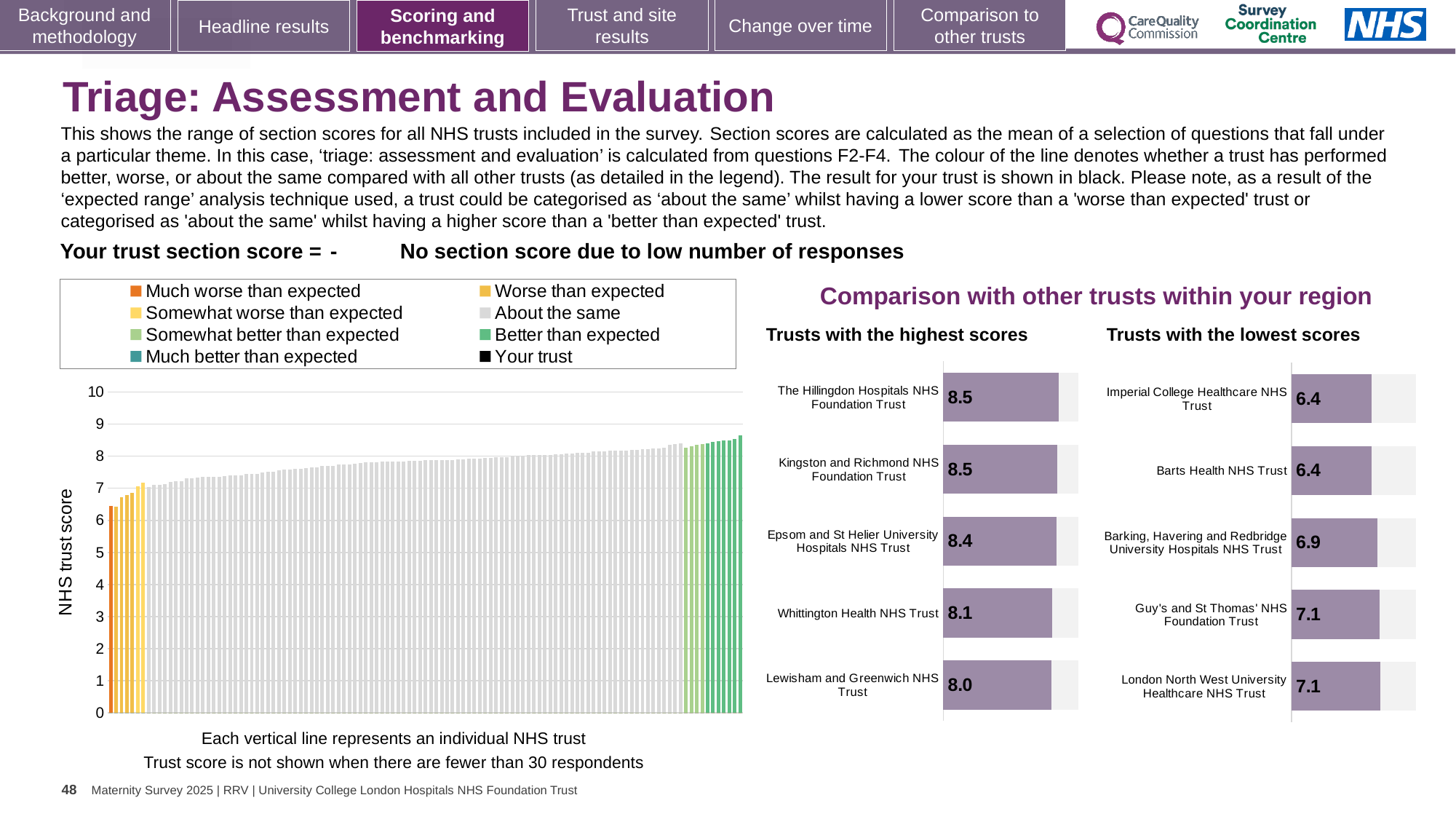
In the 'Trusts with the lowest scores' chart, what is the score for Barking, Havering and Redbridge University Hospitals NHS Trust? 6.9 In the 'Trusts with the highest scores' chart, what is the difference between the scores of The Hillingdon Hospitals NHS Foundation Trust and Lewisham and Greenwich NHS Trust? 0.5 How many entries does the legend of the main 'NHS trust score' chart list? 8 In the 'Trusts with the highest scores' chart, which trust has the lowest score? Lewisham and Greenwich NHS Trust In the 'Trusts with the lowest scores' chart, what is the score for Imperial College Healthcare NHS Trust? 6.4 How many trusts are shown in the 'Trusts with the lowest scores' chart? 5 Which has a higher score: Whittington Health NHS Trust in the 'Trusts with the highest scores' chart or Guy's and St Thomas' NHS Foundation Trust in the 'Trusts with the lowest scores' chart? Whittington Health NHS Trust In the 'Trusts with the highest scores' chart, what is the score for Epsom and St Helier University Hospitals NHS Trust? 8.4 In the main 'NHS trust score' chart, do the values rise or fall from left to right? rise In the 'Trusts with the lowest scores' chart, what is the difference between the scores of Barking, Havering and Redbridge University Hospitals NHS Trust and Barts Health NHS Trust? 0.5 In the 'Trusts with the highest scores' chart, what is the score for The Hillingdon Hospitals NHS Foundation Trust? 8.5 In the main 'NHS trust score' chart, is the value of the leftmost bar greater or less than 7? less